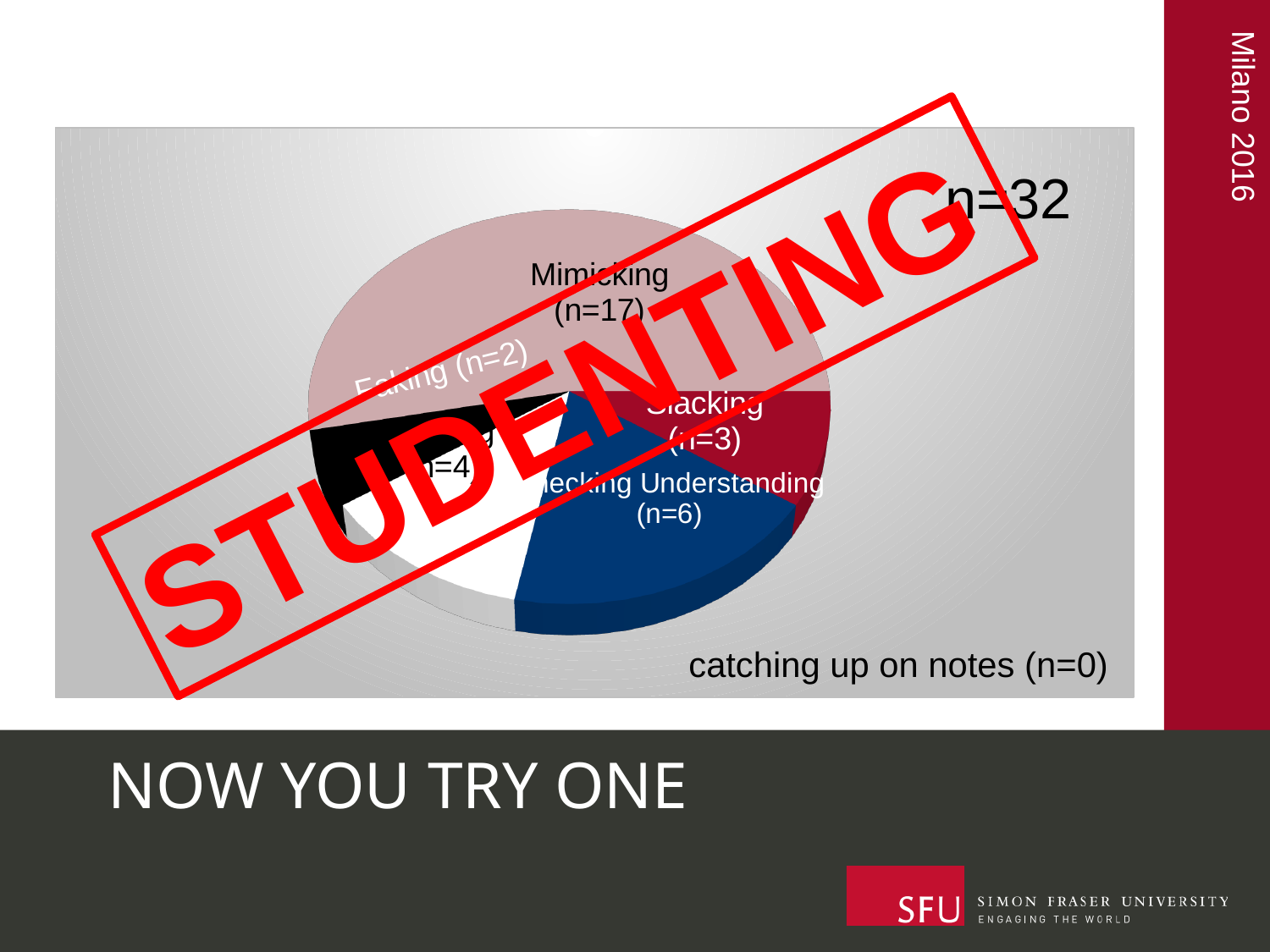
What is the value shown for catching up on notes? n=0 What is the difference between the values for Mimicking and Checking Understanding? 11 What kind of chart is shown on the slide? pie chart How many category labels are shown on the pie chart? 6 What total n is printed on the chart? n=32 Which category has the largest slice of the pie? Mimicking What word is stamped in red across the chart? STUDENTING What is the value shown for Mimicking? n=17 Which category has the smallest value? catching up on notes Which is larger, Mimicking or Checking Understanding? Mimicking What is the value shown for Slacking? n=3 What is the value shown for Checking Understanding? n=6